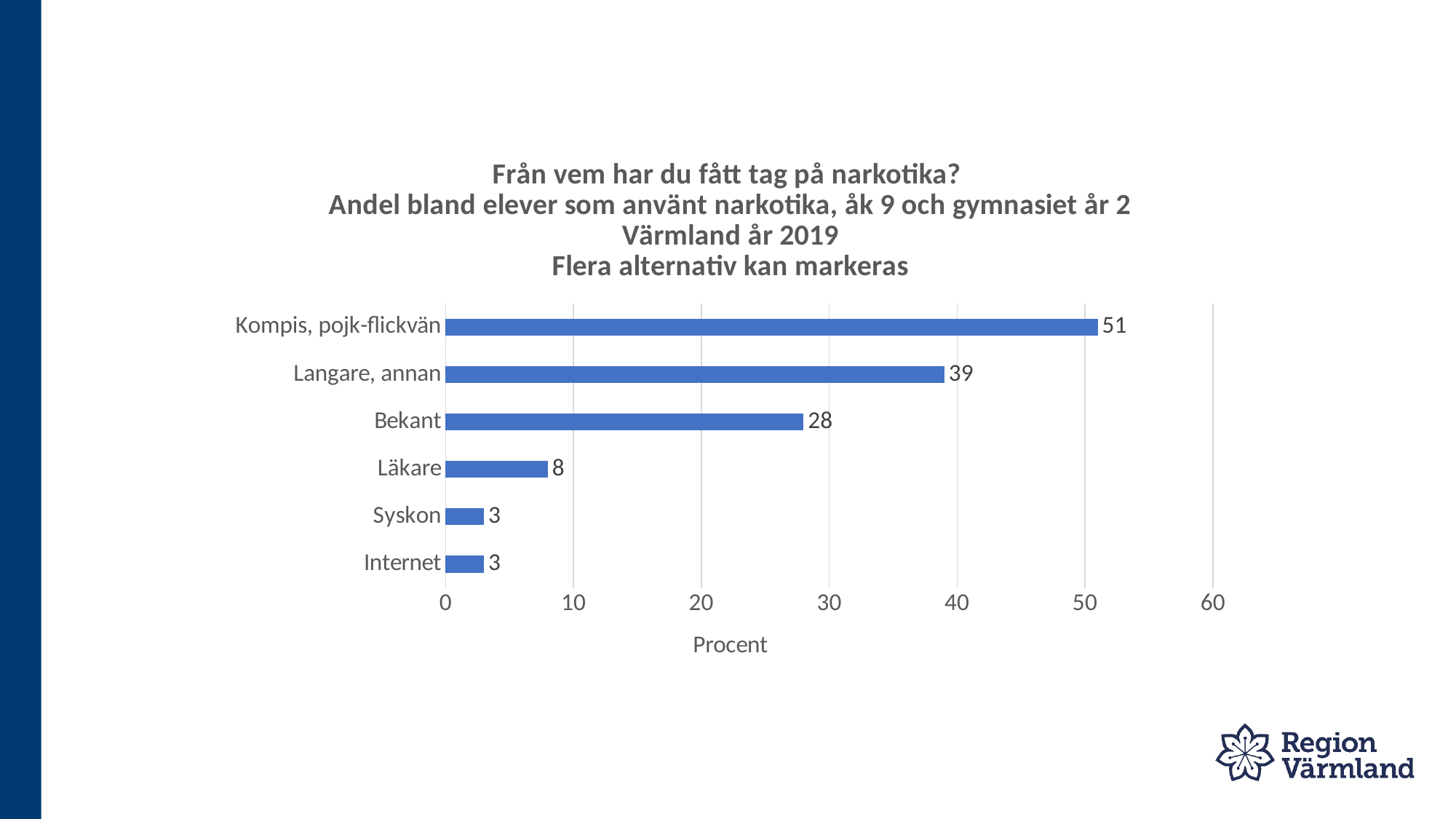
What kind of chart is shown on the slide? bar chart What is the value for Bekant? 28 What is the value for Läkare? 8 How many categories are shown in the chart? 6 What is the value for Langare, annan? 39 What is the difference between the values for Bekant and Läkare? 20 What is the difference between the values for Kompis, pojk-flickvän and Langare, annan? 12 What is the label of the horizontal axis? Procent Is the value for Kompis, pojk-flickvän greater or less than 40? greater What is the value for Kompis, pojk-flickvän? 51 Which category has the highest value? Kompis, pojk-flickvän Which is larger, the value for Langare, annan or the value for Bekant? Langare, annan